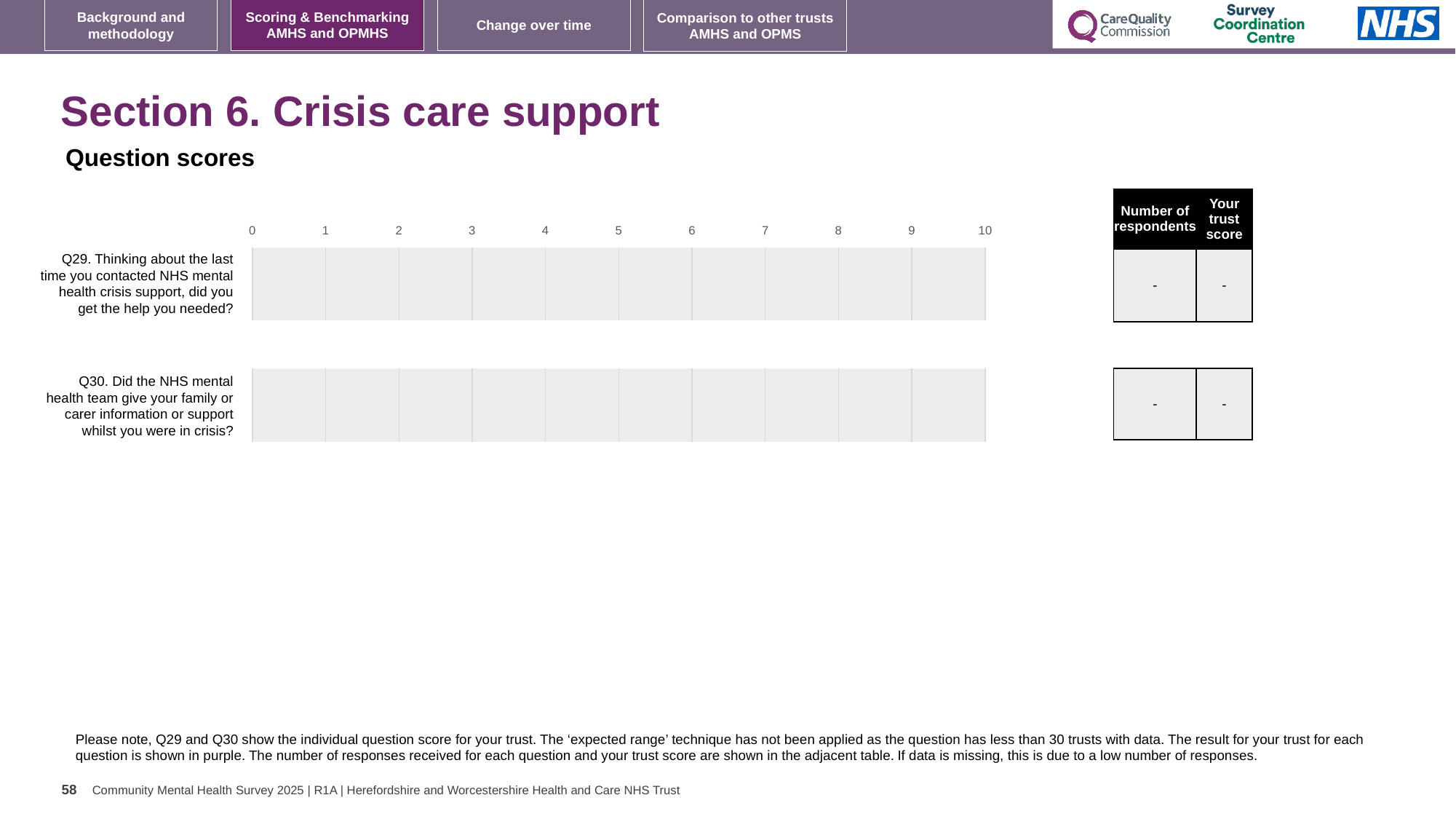
What is the highest value shown on the chart's horizontal axis? 10 What kind of chart is used to show the question scores? Bar chart What is the 'Your trust score' shown in the table for Q29? - How many questions (categories) are shown on the chart? 2 What is the 'Number of respondents' shown in the table for Q30? - What is the lowest value shown on the chart's horizontal axis? 0